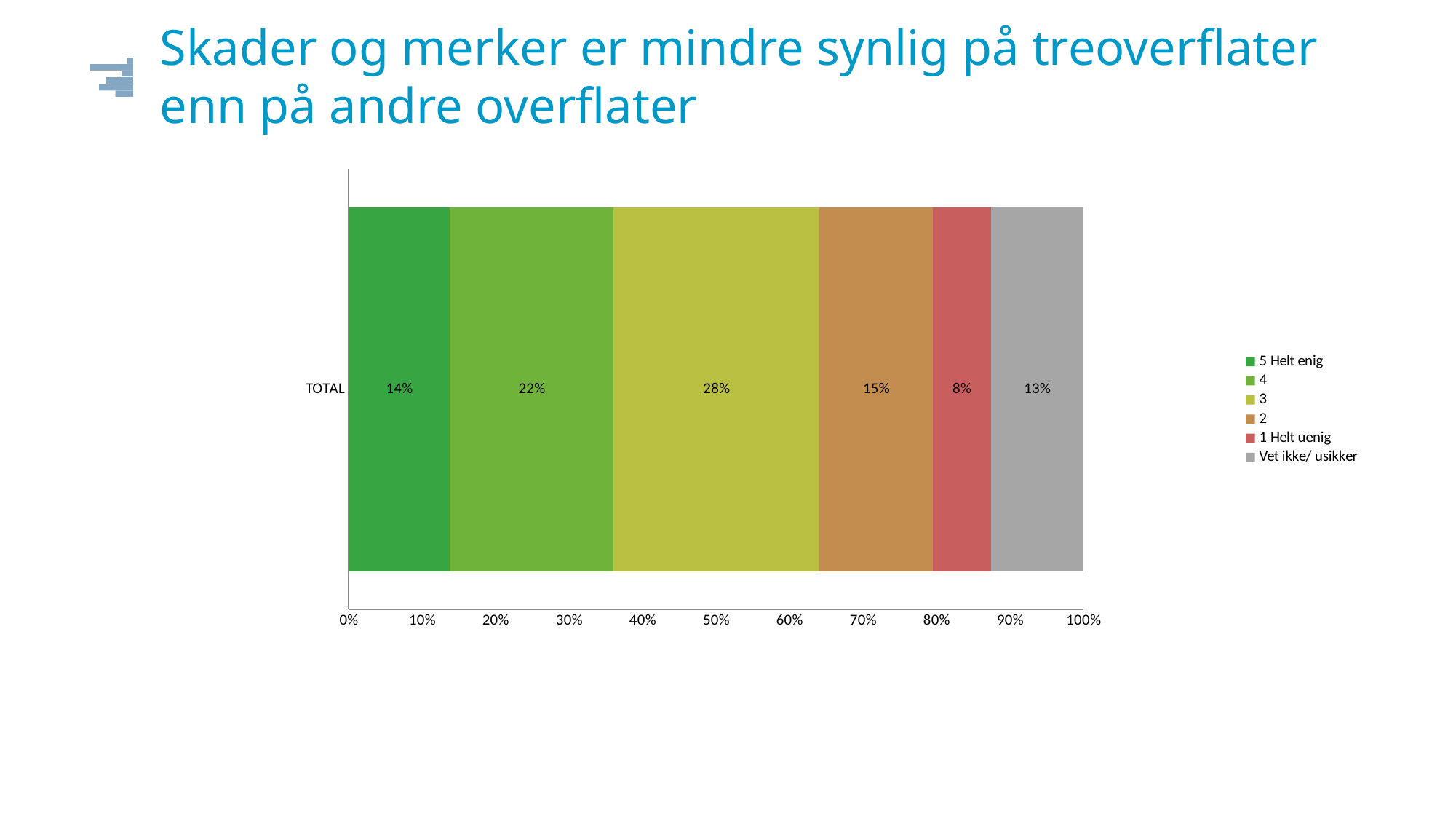
Which response category has the smallest share? 1 Helt uenig What colour represents the "Vet ikke/ usikker" category? Grey What percentage of respondents answered "5 Helt enig"? 14% What is the total of the TOTAL stacked bar? 100% Which response category has the largest share? 3 What is the difference in percentage points between the "4" and "2" categories? 7 What percentage of respondents answered "1 Helt uenig"? 8% What percentage of respondents answered "3"? 28% How many series does the legend list? 6 What percentage of respondents answered "Vet ikke/ usikker"? 13% What kind of chart is shown on the slide? Stacked bar chart Which is larger, the share for "5 Helt enig" or the share for "4"? 4